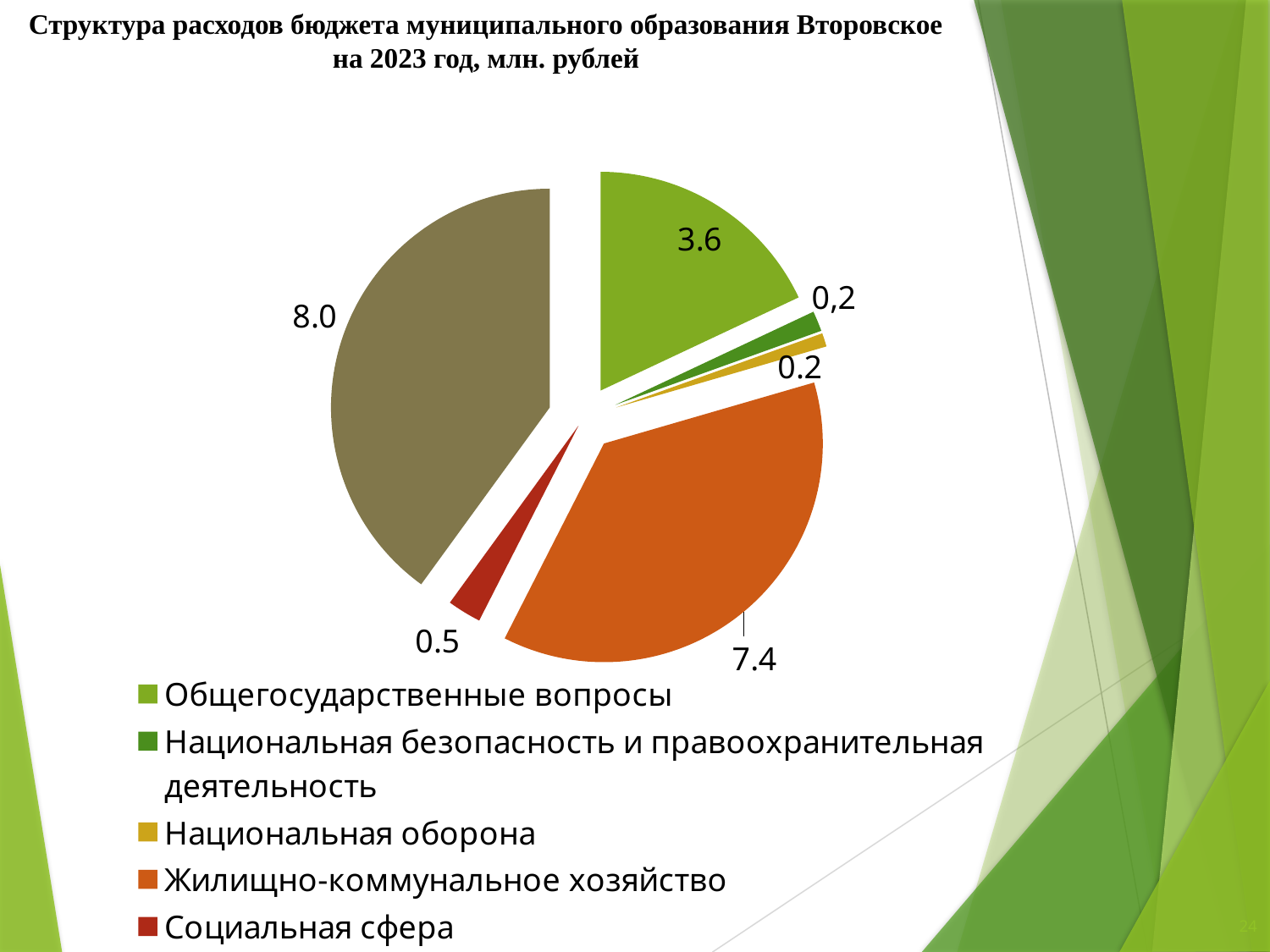
What is the value for Национальная оборона in the pie chart? 0.2 What is the value of the largest slice in the pie chart? 8.0 What is the value for Общегосударственные вопросы in the pie chart? 3.6 What kind of chart is shown on the slide? Pie chart What is the difference between the values for Жилищно-коммунальное хозяйство and Общегосударственные вопросы? 3.8 What is the difference between the values for Общегосударственные вопросы and Социальная сфера? 3.1 Which is larger, Жилищно-коммунальное хозяйство or Общегосударственные вопросы? Жилищно-коммунальное хозяйство Which is larger, Социальная сфера or Национальная оборона? Социальная сфера What is the value for Национальная безопасность и правоохранительная деятельность in the pie chart? 0,2 How many slices does the pie chart have? 6 What is the value for Жилищно-коммунальное хозяйство in the pie chart? 7.4 What is the value for Социальная сфера in the pie chart? 0.5